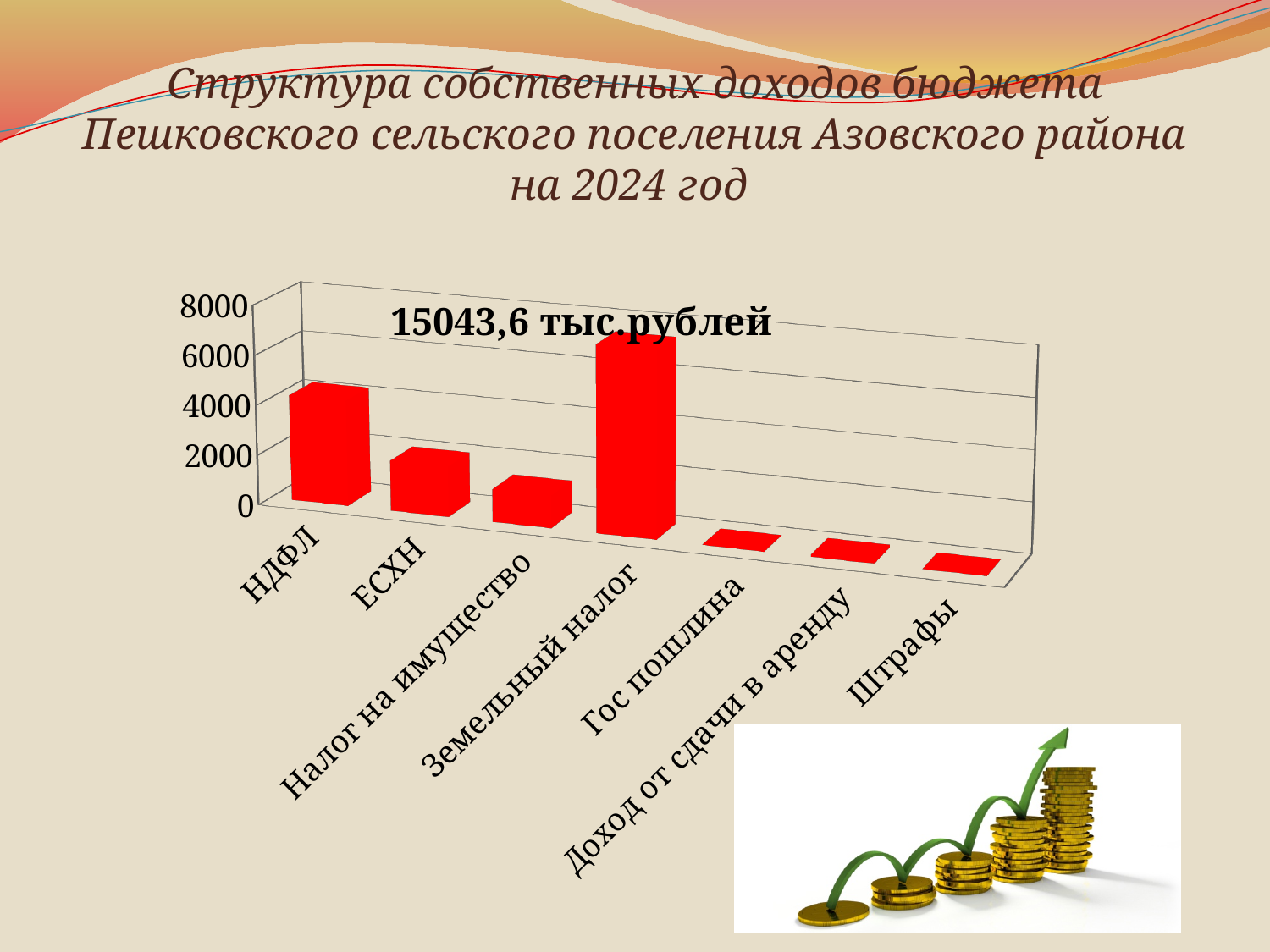
How many categories are shown on the x axis of the chart? 7 Is the value for Налог на имущество greater or less than 2000? less What colour are the bars in the chart? red Is the value for НДФЛ greater or less than 2000? greater Is the value for Земельный налог greater or less than 4000? greater What total amount is printed inside the chart area? 15043,6 тыс.рублей Which is larger, the value for НДФЛ or the value for ЕСХН? НДФЛ Which category has the highest value in the chart? Земельный налог What kind of chart is shown on the slide? bar chart Which is larger, the value for Земельный налог or the value for НДФЛ? Земельный налог Which is larger, the value for ЕСХН or the value for Налог на имущество? ЕСХН